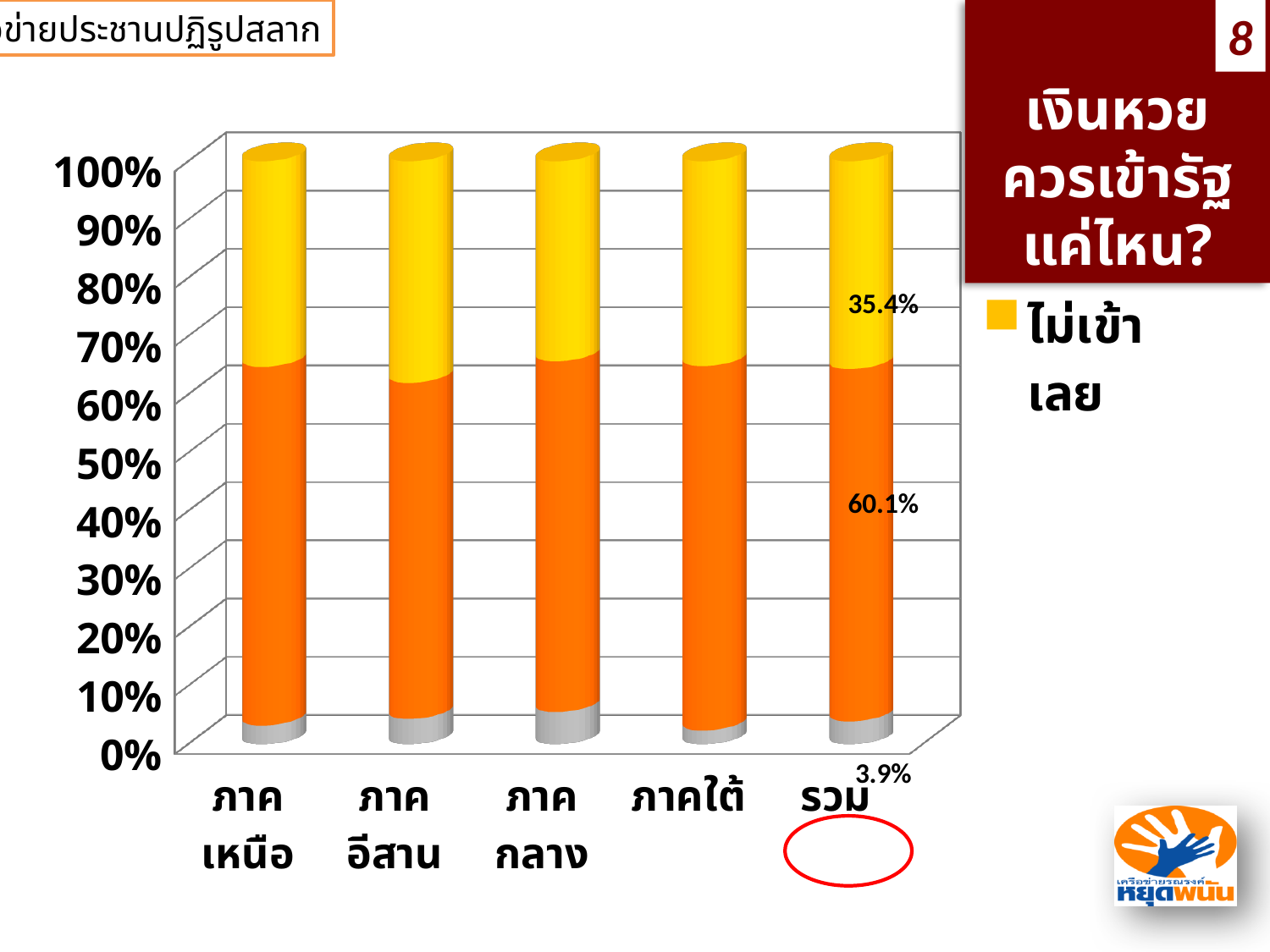
Is the gray segment for ภาคกลาง greater or less than 10%? less Which category label on the x axis is circled in red? รวม What is the value of the gray segment for รวม? 3.9% Which legend entry is shown for the yellow series? ไม่เข้าเลย What is the value of the orange segment for รวม? 60.1% What is the value of the yellow (ไม่เข้าเลย) segment for รวม? 35.4% What is the total of the three labelled segments in the รวม bar? 99.4% How many categories are shown along the x axis of the chart? 5 What is the difference between the orange segment (60.1%) and the yellow segment (35.4%) in the รวม bar? 24.7% What kind of chart is shown on the slide? bar chart In the รวม bar, which is larger: the orange segment or the yellow segment? the orange segment Does the top of the orange segment for ภาคอีสาน lie above or below 70%? below